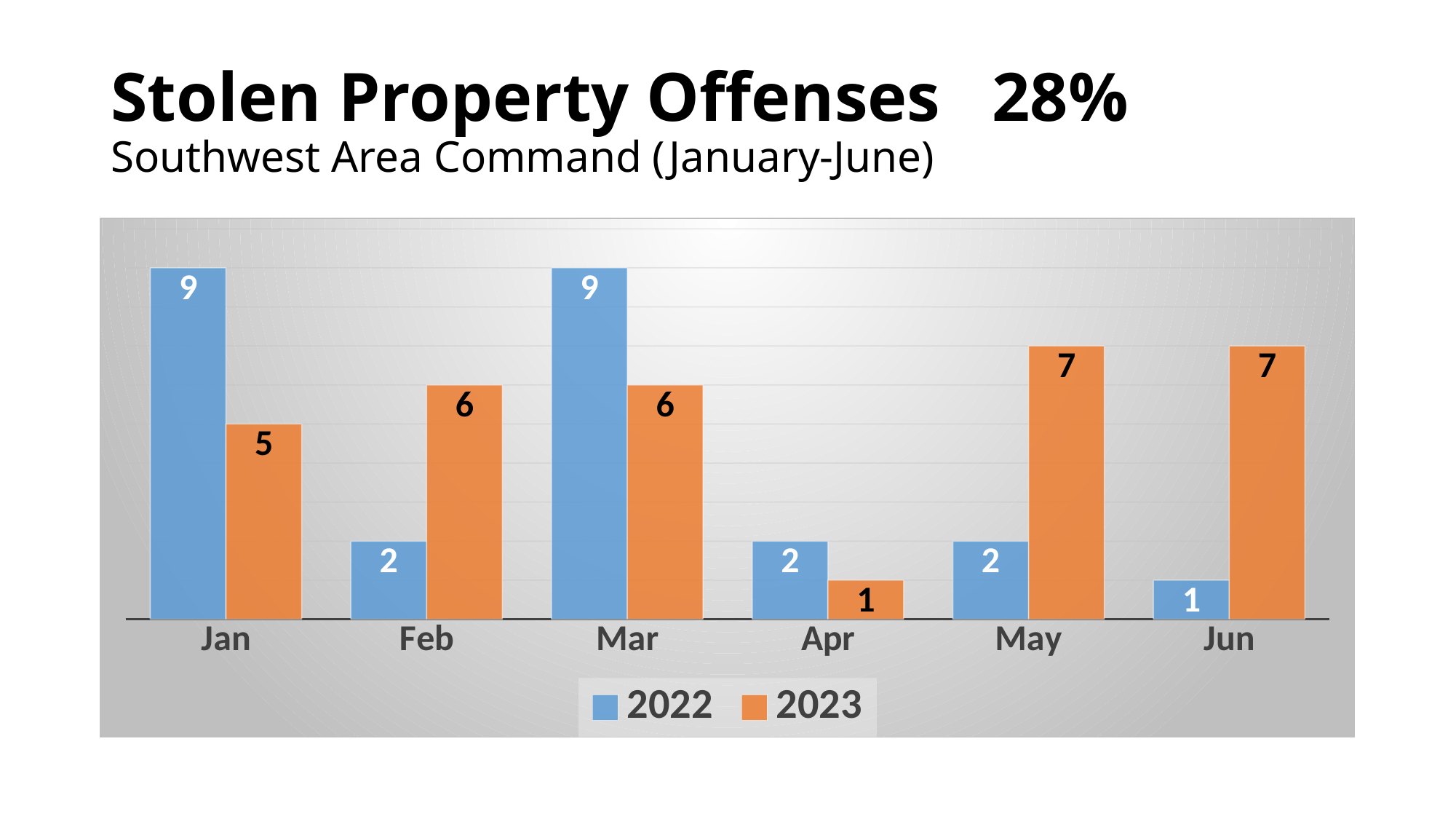
What is the difference between the 2022 and 2023 values in Jan? 4 Which is larger in Feb, the 2022 value or the 2023 value? 2023 What is the title of the chart? Stolen Property Offenses What is the value for 2023 in May? 7 Which month has the lowest value for 2023? Apr What kind of chart is shown on the slide? bar chart What is the value for 2023 in Apr? 1 Which month has the highest value for 2023? May and Jun How many series does the legend list? 2 What is the value for 2022 in Jun? 1 How many months are shown on the x axis? 6 What is the value for 2022 in Jan? 9